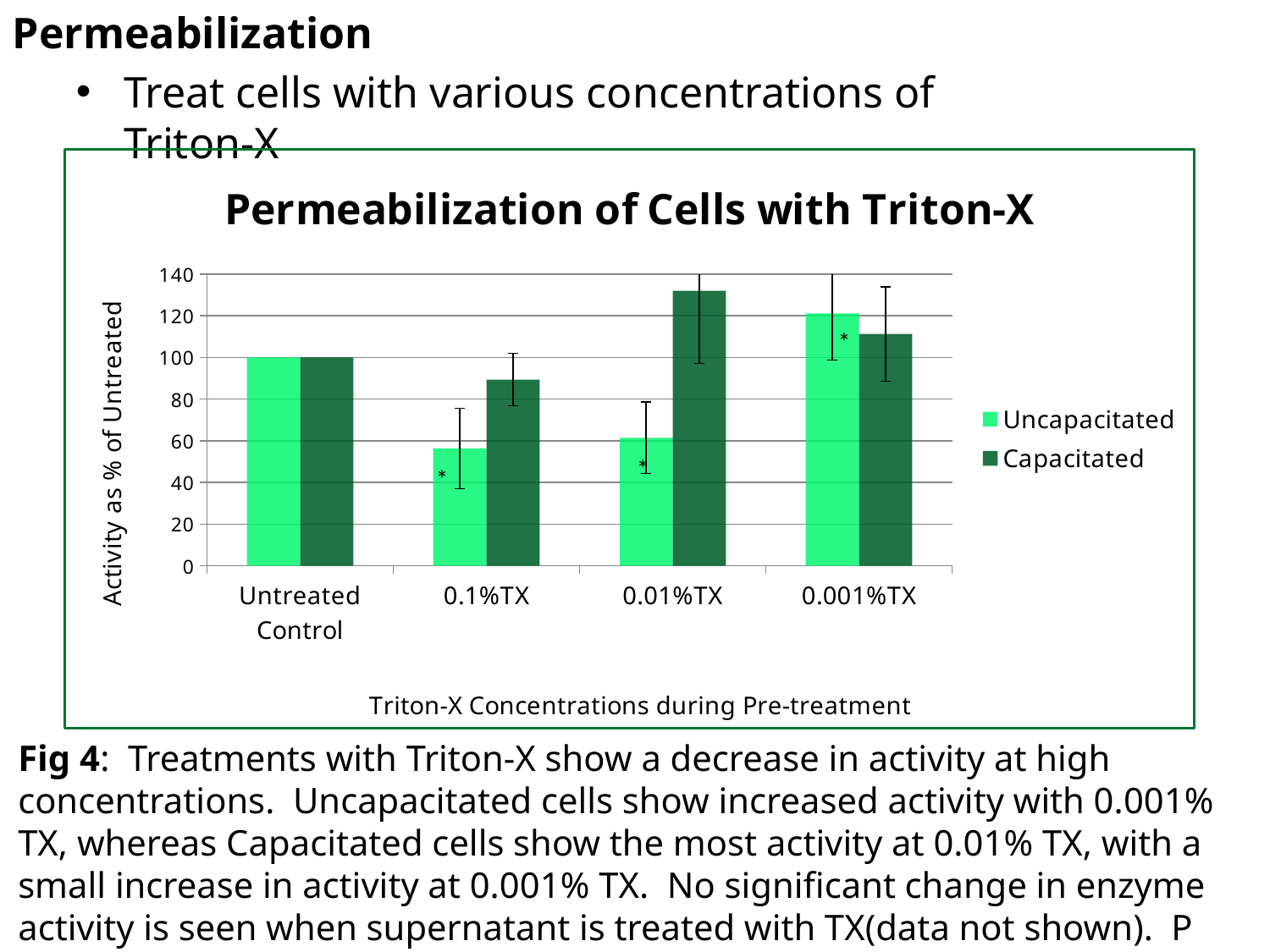
How many series does the legend list? 2 What kind of chart is shown on the slide? bar chart Is the Capacitated value at 0.01%TX greater or less than 120? greater What is the title of the chart? Permeabilization of Cells with Triton-X Which category has the highest Capacitated value? 0.01%TX Which category has the lowest Uncapacitated value? 0.1%TX Is the Uncapacitated value at 0.001%TX greater or less than 100? greater What is the Uncapacitated value for the Untreated Control? 100 How many Triton-X concentration categories are shown on the x axis? 4 At 0.01%TX, which series has the larger value, Uncapacitated or Capacitated? Capacitated Is the Uncapacitated value at 0.1%TX greater or less than 80? less What is the Capacitated value for the Untreated Control? 100